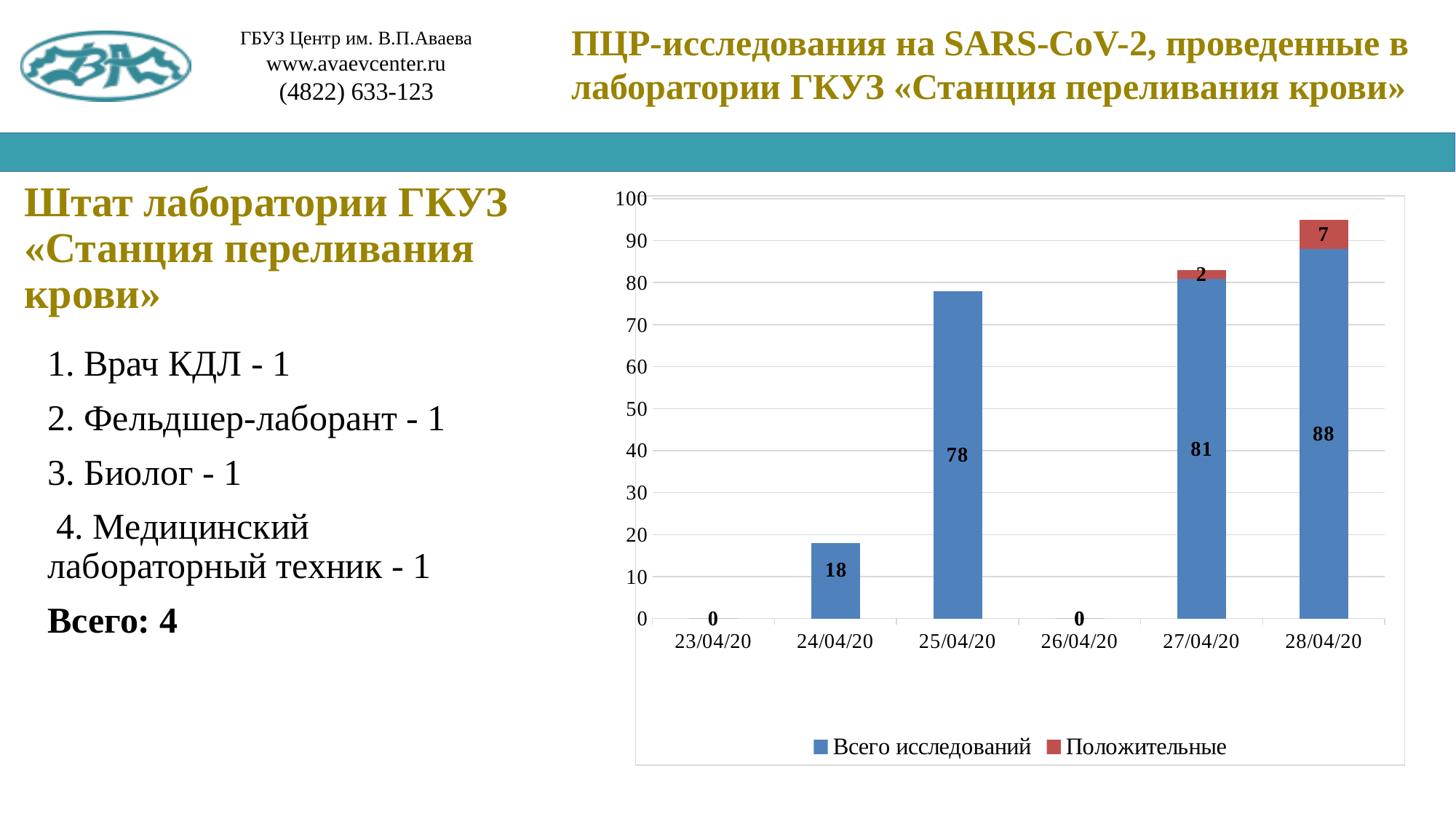
Which is larger: the "Всего исследований" value for 25/04/20 or for 27/04/20? 27/04/20 What kind of chart is shown on the slide? Stacked bar chart How many series does the legend list? 2 How many dates are shown on the x axis? 6 Which colour represents "Положительные" in the chart? Red What is the value of "Положительные" for 27/04/20? 2 What is the total height of the stacked bar for 28/04/20? 95 What is the value of "Всего исследований" for 28/04/20? 88 What is the difference between the "Всего исследований" values for 28/04/20 and 25/04/20? 10 What is the value of "Всего исследований" for 24/04/20? 18 Which date has the highest value for "Всего исследований"? 28/04/20 Which dates have a value of 0 for "Всего исследований"? 23/04/20 and 26/04/20